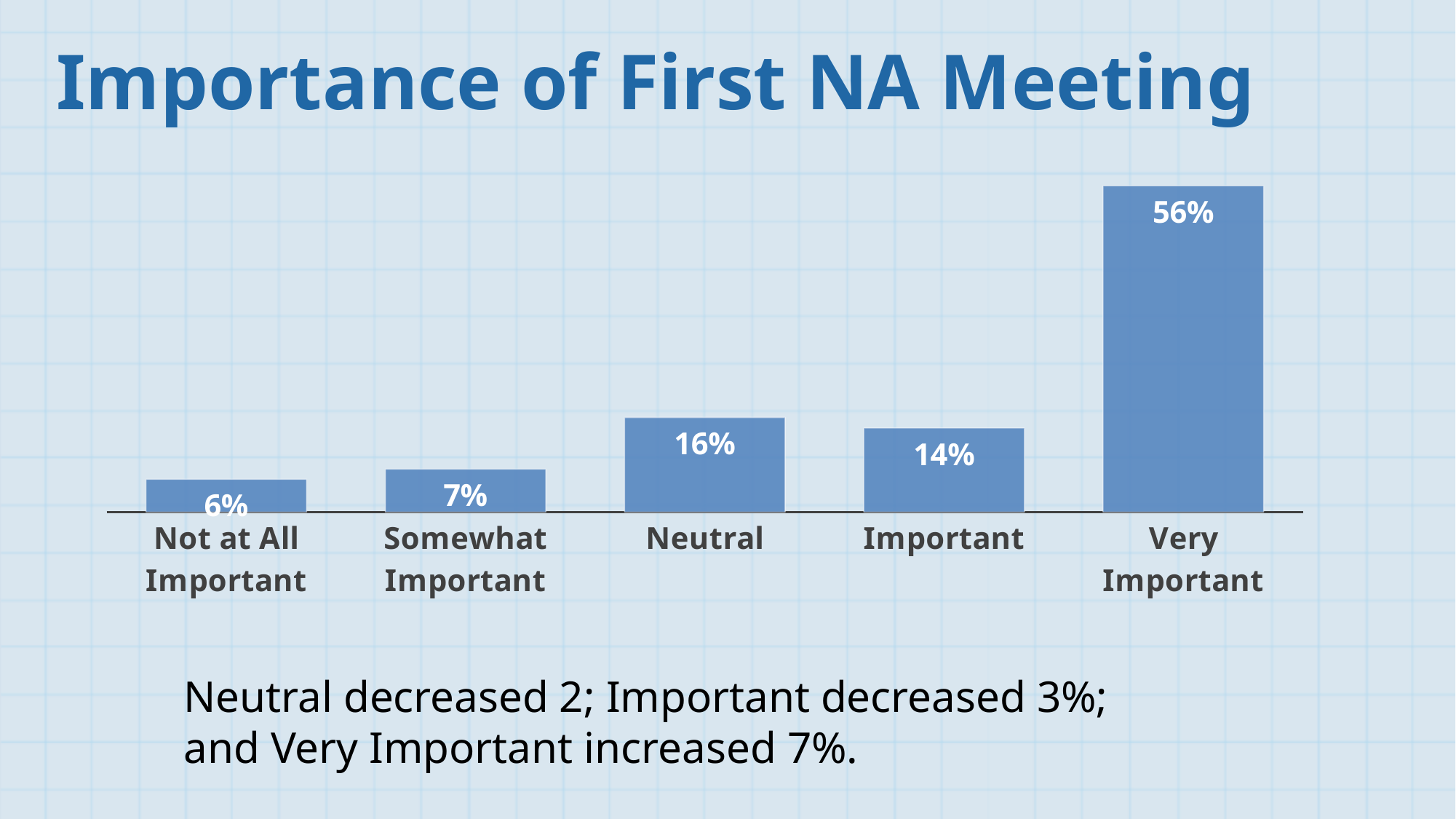
What kind of chart is shown on the slide? Bar chart What is the value shown for Neutral? 16% What is the difference between the Very Important and Important values? 42% What percentage of respondents rated the first NA meeting as Very Important? 56% What is the title of the chart? Importance of First NA Meeting Which category has the lowest value? Not at All Important What is the value shown for Not at All Important? 6% Which is larger, the value for Neutral or the value for Important? Neutral Which category has the highest value? Very Important What is the value shown for Somewhat Important? 7% How many categories are shown on the x axis? 5 What is the difference between the Neutral and Important values? 2%